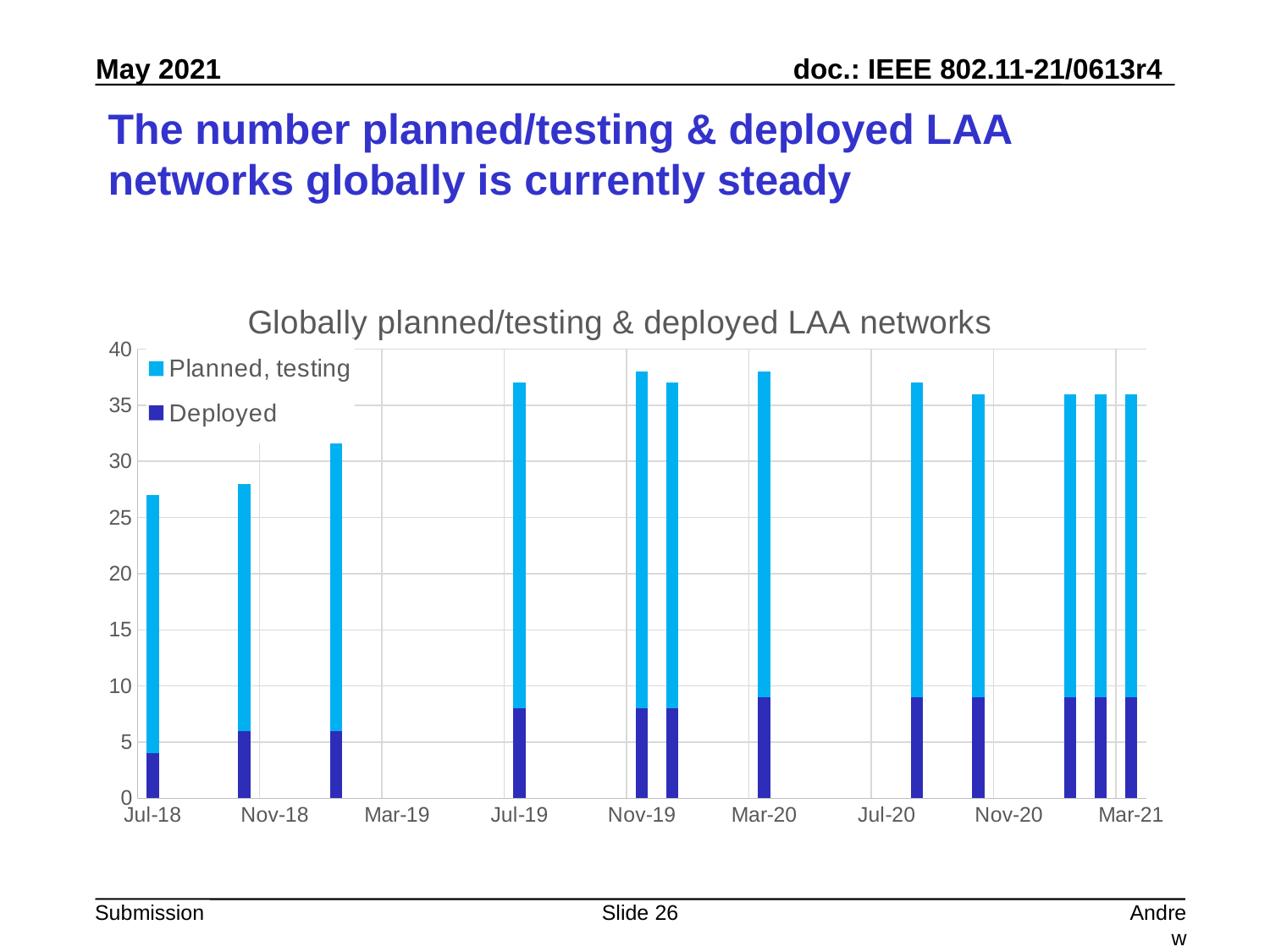
What kind of chart is shown on the slide? stacked bar chart What is the title of the chart? Globally planned/testing & deployed LAA networks Is the total height of the bar at Jul-18 greater or less than 30? less Is the Deployed value for the bar at Mar-21 greater or less than 5? greater Which bar has the lowest total, the one at Jul-18 or the one at Mar-21? Jul-18 Which x-axis date has the lowest total bar height? Jul-18 Is the Deployed value for the bar at Jul-18 greater or less than 5? less What are the two series named in the legend? Planned, testing; Deployed How many bars are plotted in the chart? 12 How many series does the legend list? 2 Do the total bar heights generally rise or fall from Jul-18 to Mar-21? rise